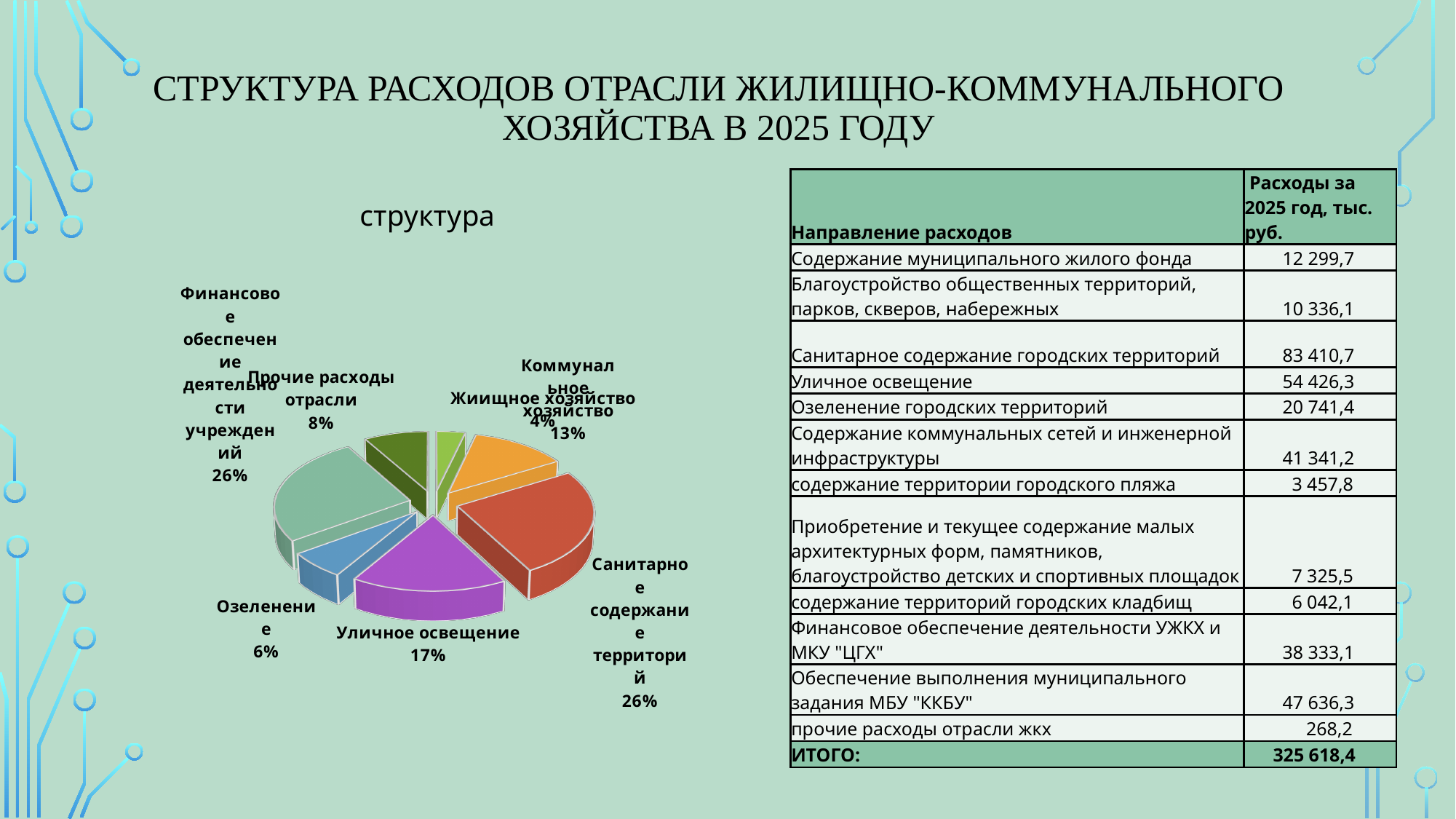
Which category has the smallest share of the pie? Жиищное хозяйство What is the difference in percentage points between Финансовое обеспечение деятельности учреждений and Озеленение? 20 What is the difference in percentage points between Уличное освещение and Прочие расходы отрасли? 9 What kind of chart is shown on the slide? pie chart What share of the pie does Уличное освещение have? 17% How many slices does the pie chart have? 7 What percentage is shown for Санитарное содержание территорий? 26% What percentage is shown for Озеленение? 6% What percentage is shown for Прочие расходы отрасли? 8% What is the title of the chart? структура What percentage is shown for Коммунальное хозяйство? 13% Which is larger: the share for Уличное освещение or the share for Коммунальное хозяйство? Уличное освещение